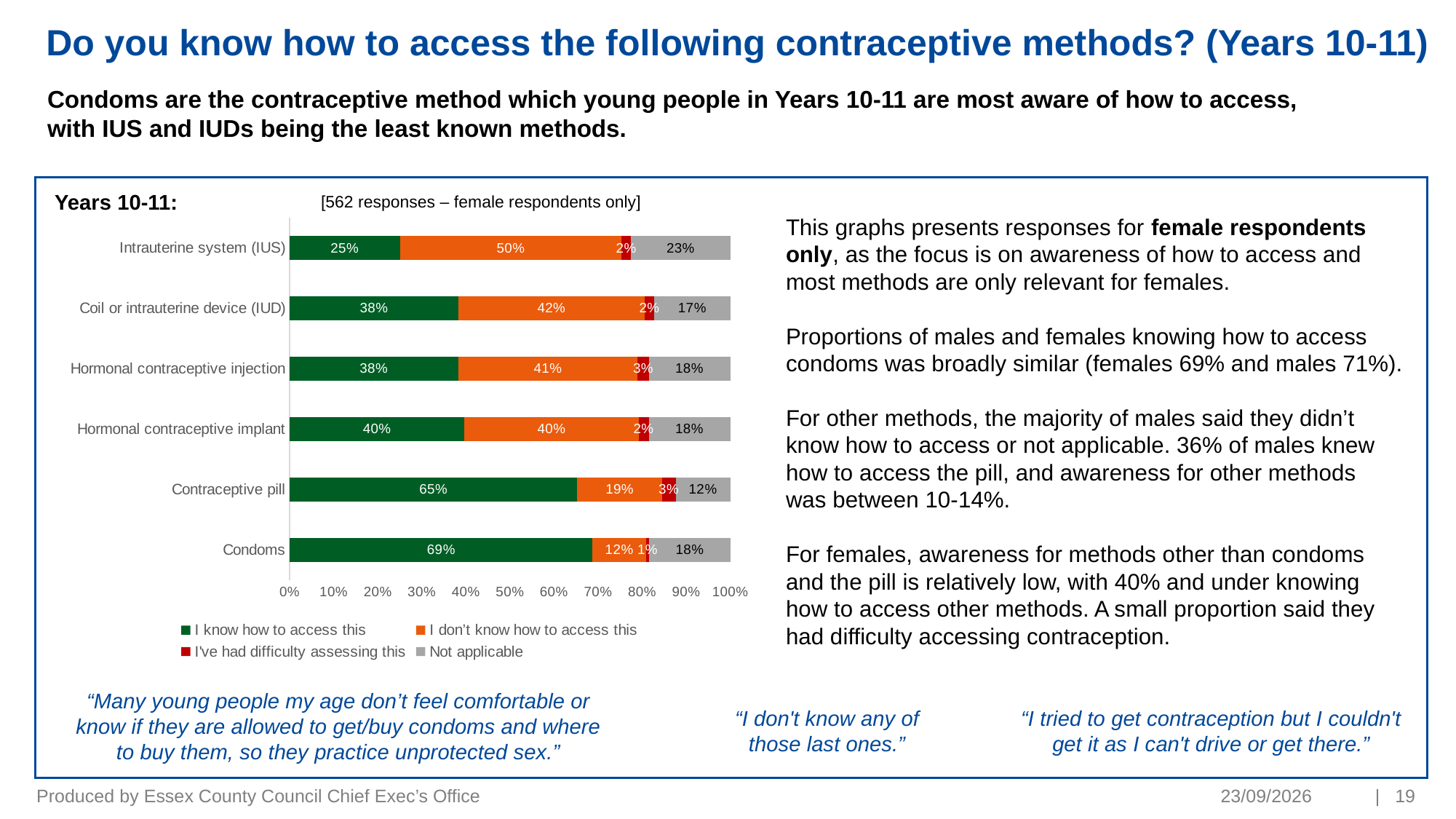
Which contraceptive method has the highest 'I know how to access this' percentage? Condoms What percentage of female respondents said they know how to access condoms? 69% How many responses does the chart subtitle say the chart is based on? 562 responses How many series does the chart legend list? 4 How many contraceptive methods are shown on the chart? 6 What percentage of respondents said they don't know how to access the intrauterine system (IUS)? 50% Which contraceptive method has the lowest 'I know how to access this' percentage? Intrauterine system (IUS) What type of chart is shown on the slide? Stacked bar chart What is the 'Not applicable' value for the contraceptive pill? 12% What is the 'I've had difficulty assessing this' value for the hormonal contraceptive injection? 3% Which is larger: the 'I don't know how to access this' value for the IUD or for the hormonal contraceptive injection? IUD What is the difference between the 'I know how to access this' percentages for condoms and the contraceptive pill? 4%